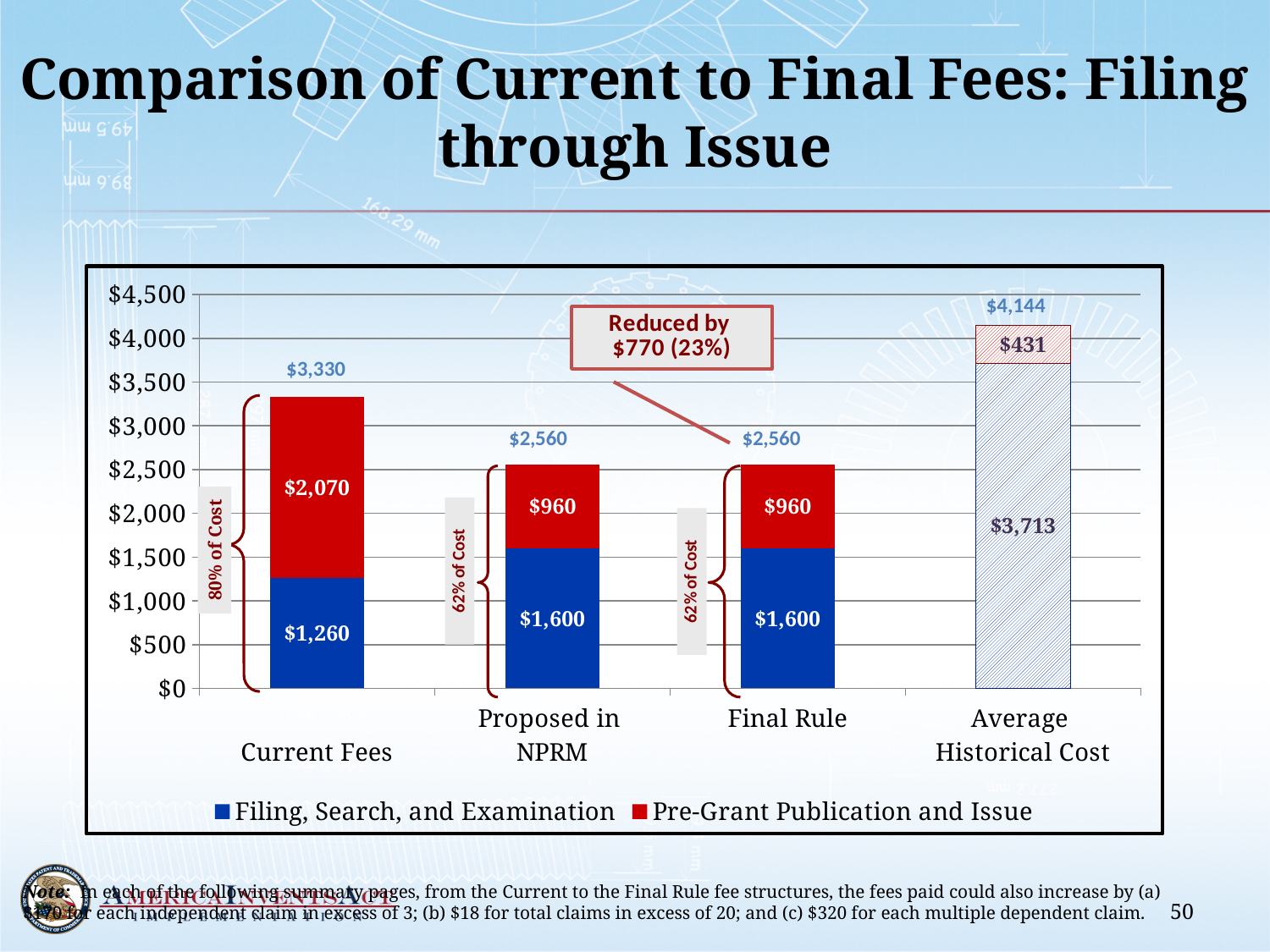
What is the difference between the total for Current Fees and the total for Final Rule? $770 Which category has the highest total bar? Average Historical Cost Which is larger, the Pre-Grant Publication and Issue value for Current Fees or for Proposed in NPRM? Current Fees What is the Pre-Grant Publication and Issue value for Current Fees? $2,070 What is the total of the stacked bar for Average Historical Cost? $4,144 How many categories are shown on the x axis of the chart? 4 What is the Pre-Grant Publication and Issue value for Average Historical Cost? $431 What is the total of the stacked bar for Current Fees? $3,330 How many series does the legend list? 2 What is the Filing, Search, and Examination value for Current Fees? $1,260 What is the Filing, Search, and Examination value for Final Rule? $1,600 What type of chart is shown on the slide? Stacked bar chart